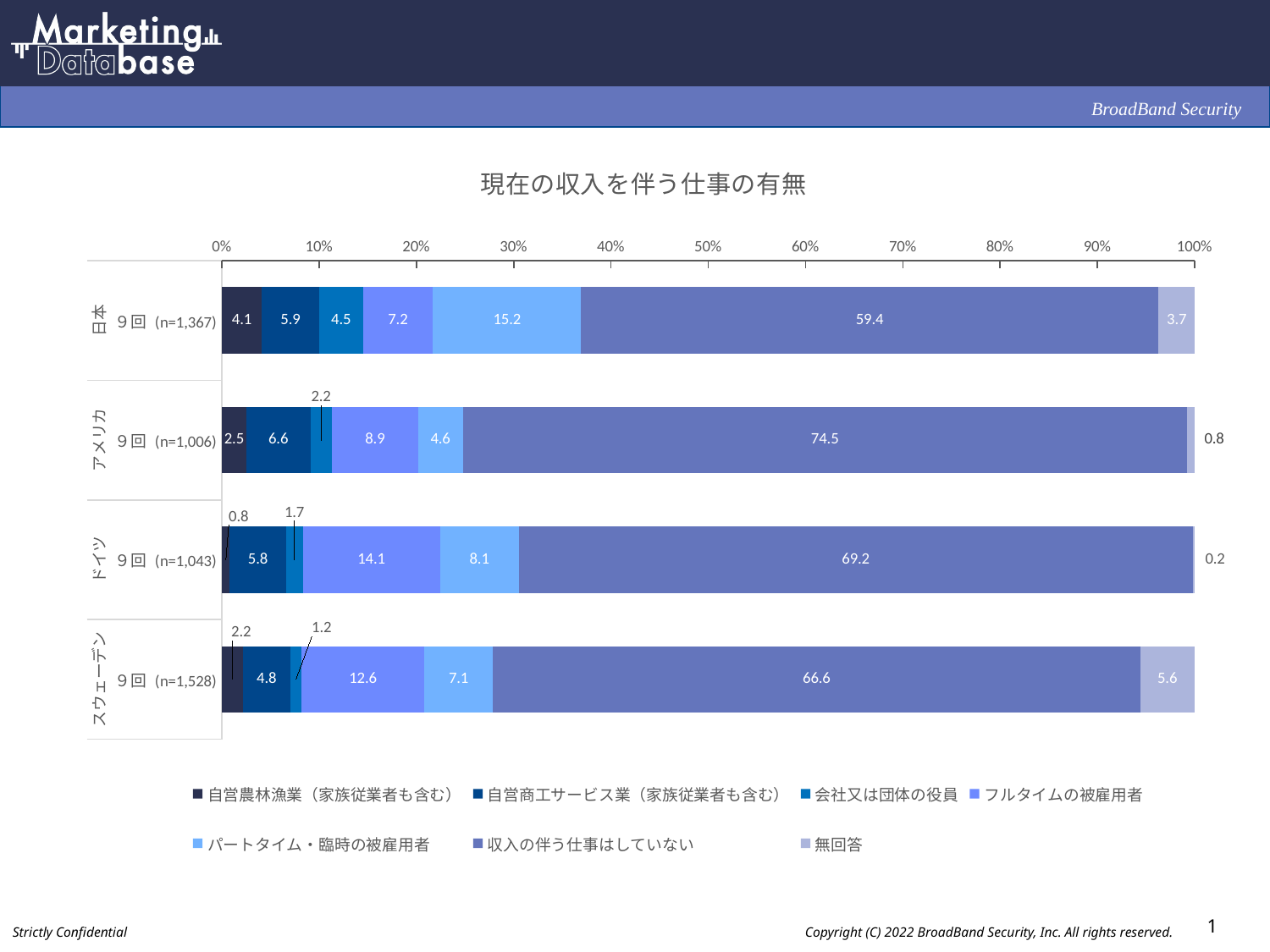
Which country has the lowest value for 無回答? ドイツ Which is larger, the パートタイム・臨時の被雇用者 value for 日本 or for ドイツ? 日本 What is the value for 収入の伴う仕事はしていない for 日本 (n=1,367)? 59.4 Which country has the highest value for 収入の伴う仕事はしていない? アメリカ What is the value for フルタイムの被雇用者 for ドイツ (n=1,043)? 14.1 How many series does the legend list? 7 How many countries are shown in the chart? 4 What is the title of the chart? 現在の収入を伴う仕事の有無 What is the difference between the 収入の伴う仕事はしていない values for アメリカ and 日本? 15.1 What is the value for パートタイム・臨時の被雇用者 for アメリカ (n=1,006)? 4.6 What kind of chart is shown on the slide? Stacked bar chart What is the value for 無回答 for スウェーデン (n=1,528)? 5.6